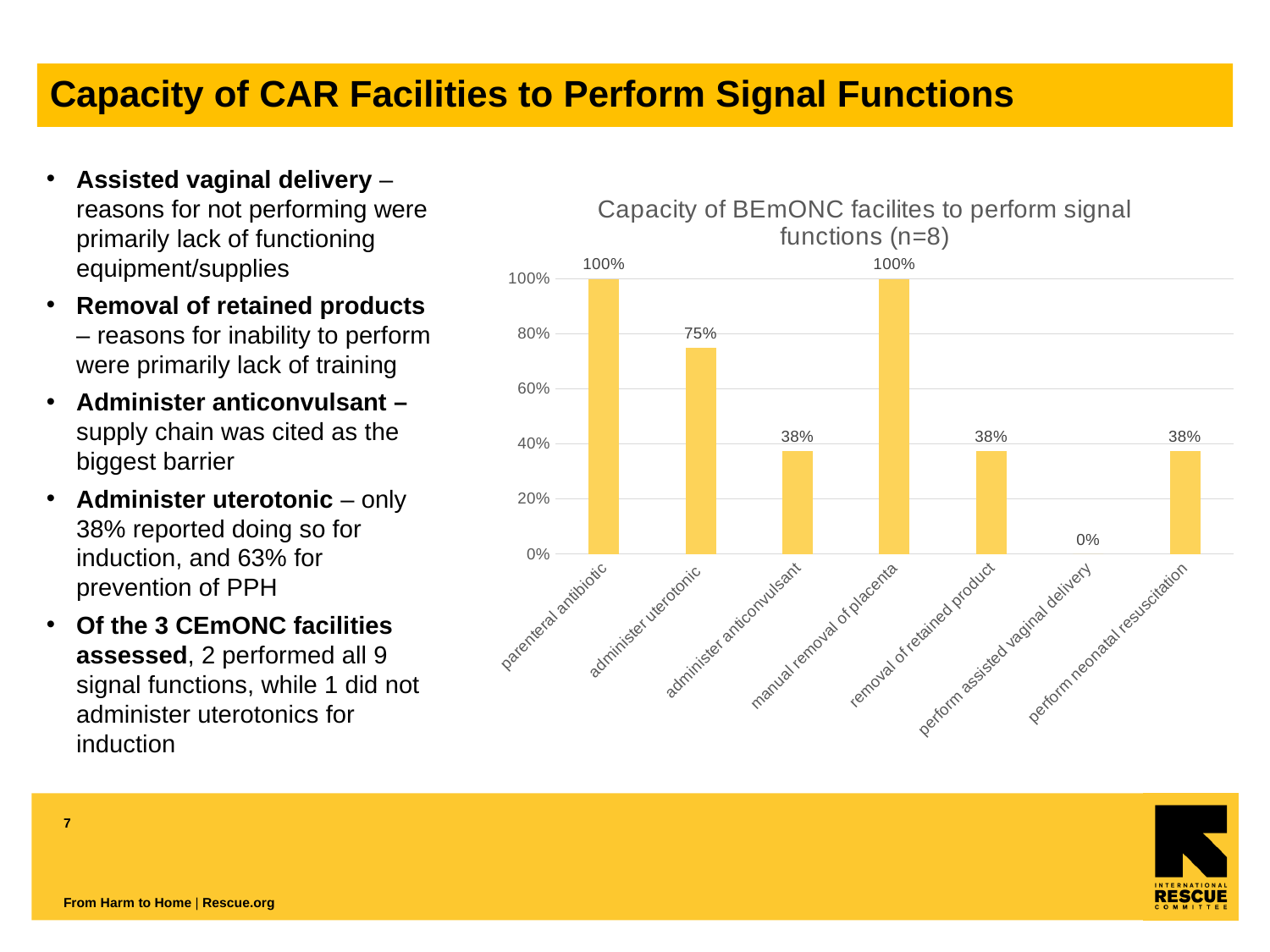
What is the value for administer uterotonic? 75% What is the value for perform assisted vaginal delivery? 0% What is the value for administer anticonvulsant? 38% What kind of chart is shown? bar chart Is the value for perform neonatal resuscitation greater or less than 60%? less Which is larger, the value for administer uterotonic or the value for removal of retained product? administer uterotonic What is the title of the chart? Capacity of BEmONC facilites to perform signal functions (n=8) What is the difference between the values for manual removal of placenta and perform neonatal resuscitation? 62% What is the difference between the values for parenteral antibiotic and administer uterotonic? 25% Which category has the lowest value? perform assisted vaginal delivery How many categories are shown on the x axis? 7 How many categories have a value of 100%? 2